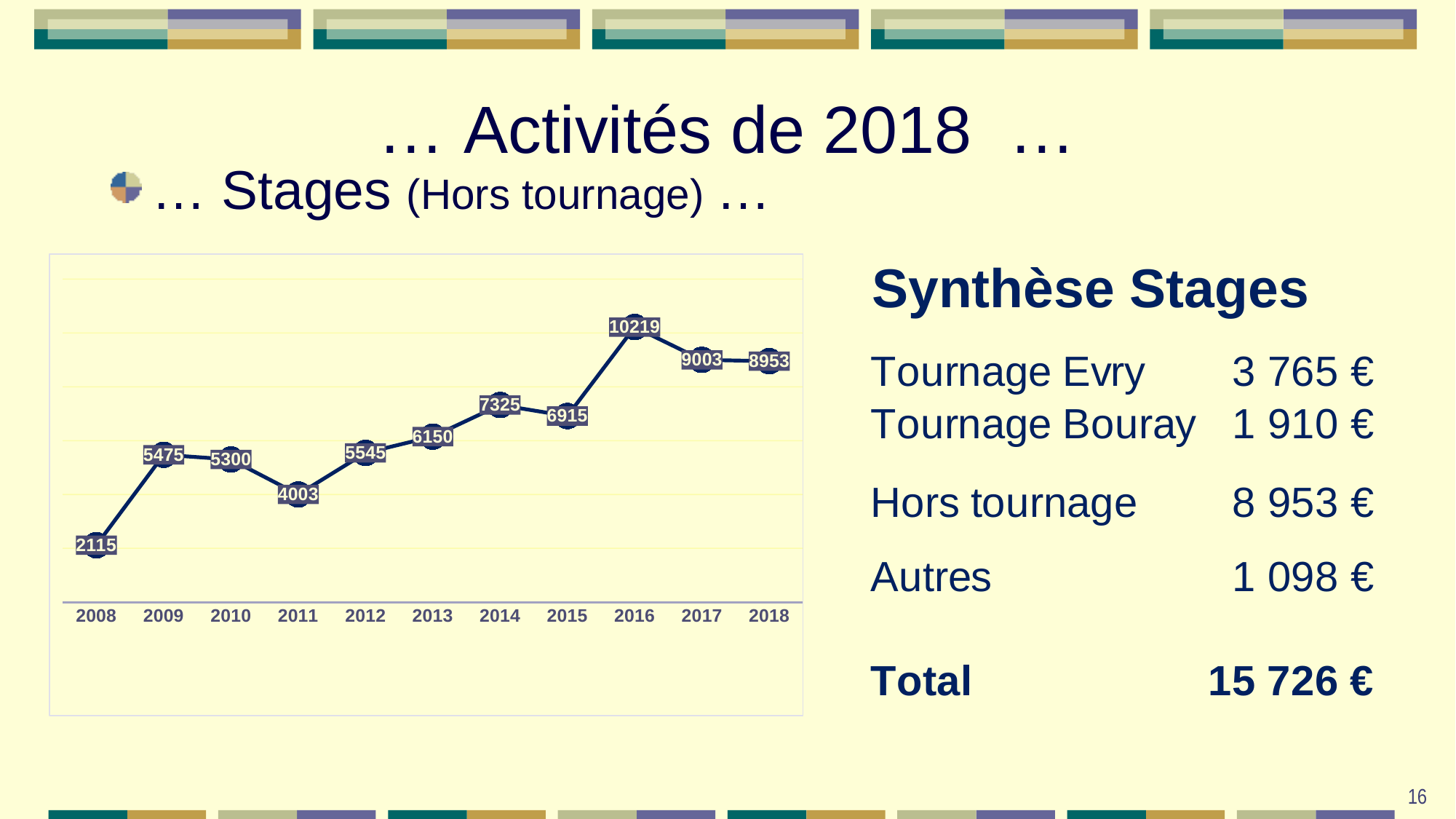
What is the value plotted for 2008? 2115 Does the value rise or fall from 2016 to 2018? fall Does the value rise or fall from 2008 to 2009? rise What kind of chart is shown on the slide? line chart Which year has the highest value on the chart? 2016 What is the difference between the values for 2016 and 2017? 1216 What is the value plotted for 2016? 10219 Which year has the lowest value on the chart? 2008 Which is larger, the value for 2014 or the value for 2015? 2014 How many years are plotted on the chart? 11 What is the value plotted for 2018? 8953 What is the difference between the values for 2011 and 2010? 1297